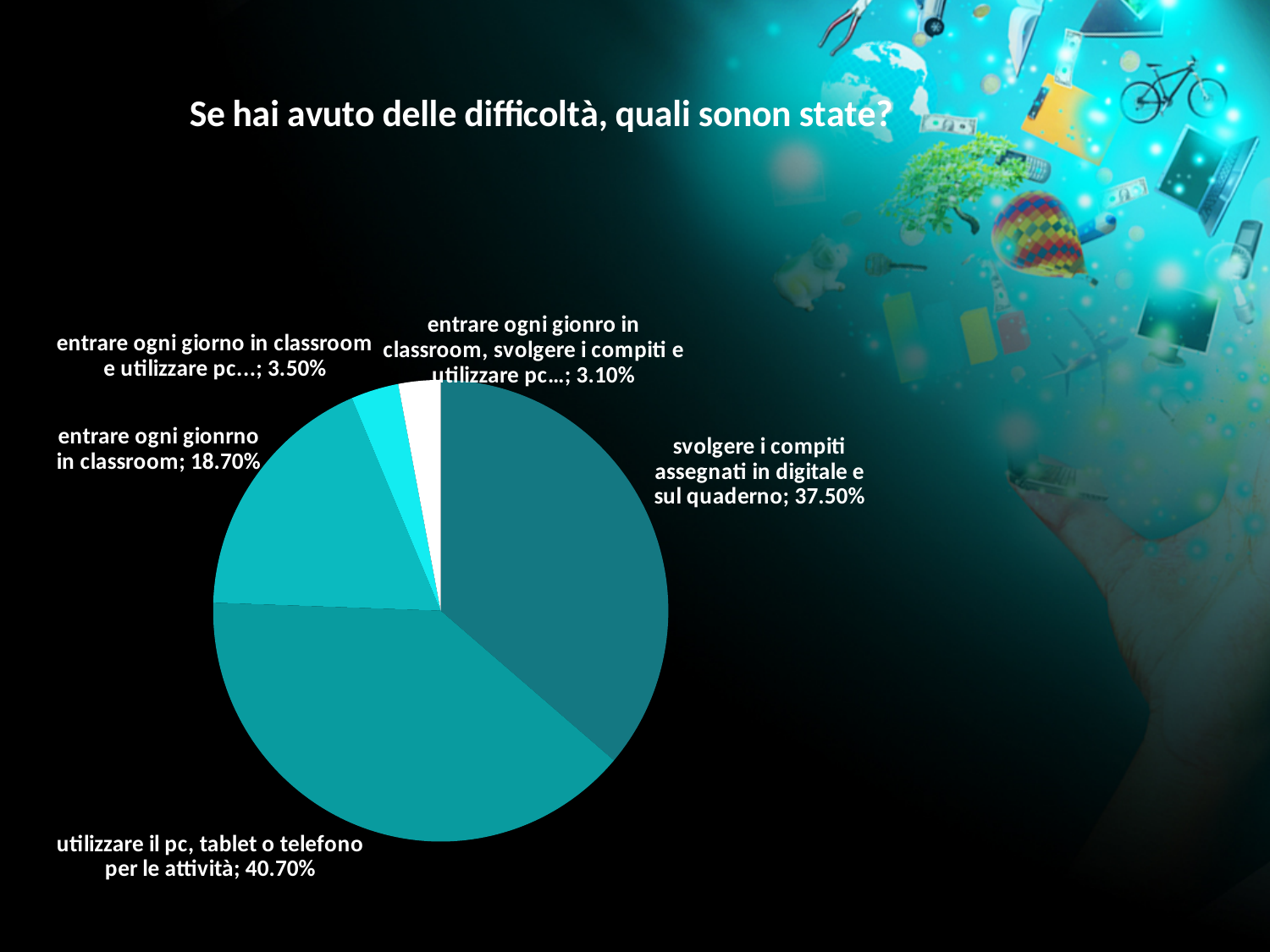
What share of the pie is labelled "utilizzare il pc, tablet o telefono per le attività"? 40.70% Which category has the largest slice of the pie? utilizzare il pc, tablet o telefono per le attività What is the combined share of the two slices "entrare ogni giorno in classroom e utilizzare pc..." and "entrare ogni gionro in classroom, svolgere i compiti e utilizzare pc…"? 6.60% What is the title of the chart? Se hai avuto delle difficoltà, quali sonon state? What share of the pie is labelled "entrare ogni gionrno in classroom"? 18.70% What share of the pie is labelled "svolgere i compiti assegnati in digitale e sul quaderno"? 37.50% What share of the pie is labelled "entrare ogni giorno in classroom e utilizzare pc..."? 3.50% How many slices does the pie chart have? 5 What is the difference between the share for "utilizzare il pc, tablet o telefono per le attività" and the share for "svolgere i compiti assegnati in digitale e sul quaderno"? 3.20% What kind of chart is shown on the slide? pie chart Which is larger: the share for "entrare ogni gionrno in classroom" or the share for "entrare ogni giorno in classroom e utilizzare pc..."? entrare ogni gionrno in classroom Which category has the smallest slice of the pie? entrare ogni gionro in classroom, svolgere i compiti e utilizzare pc…